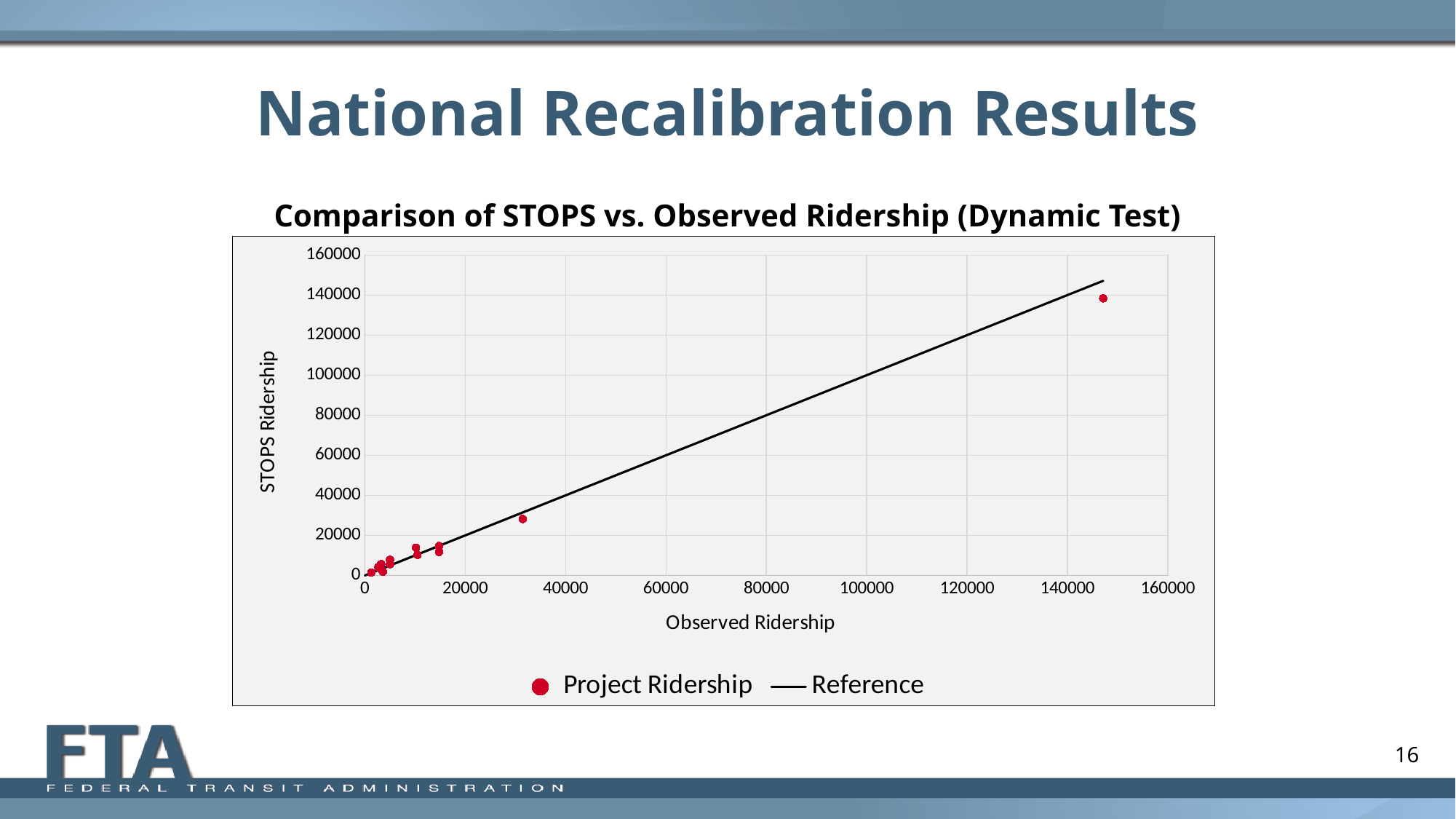
What kind of chart is shown on the slide? Scatter chart Which Project Ridership point has the highest STOPS Ridership: the one near 30000 Observed Ridership or the one near 147000 Observed Ridership? The one near 147000 Observed Ridership Is the STOPS Ridership value of the Project Ridership point near 30000 Observed Ridership greater or less than 40000? less What is the highest tick value shown on the vertical axis? 160000 What is the label of the vertical axis? STOPS Ridership What is the label of the horizontal axis? Observed Ridership Is the Observed Ridership value of the rightmost Project Ridership point greater or less than 140000? greater What is the title of the chart? Comparison of STOPS vs. Observed Ridership (Dynamic Test) Do the Project Ridership points generally rise or fall as Observed Ridership increases? Rise Is the STOPS Ridership value of the rightmost Project Ridership point greater or less than 120000? greater What are the two entries in the chart legend? Project Ridership and Reference How many series does the chart legend list? 2